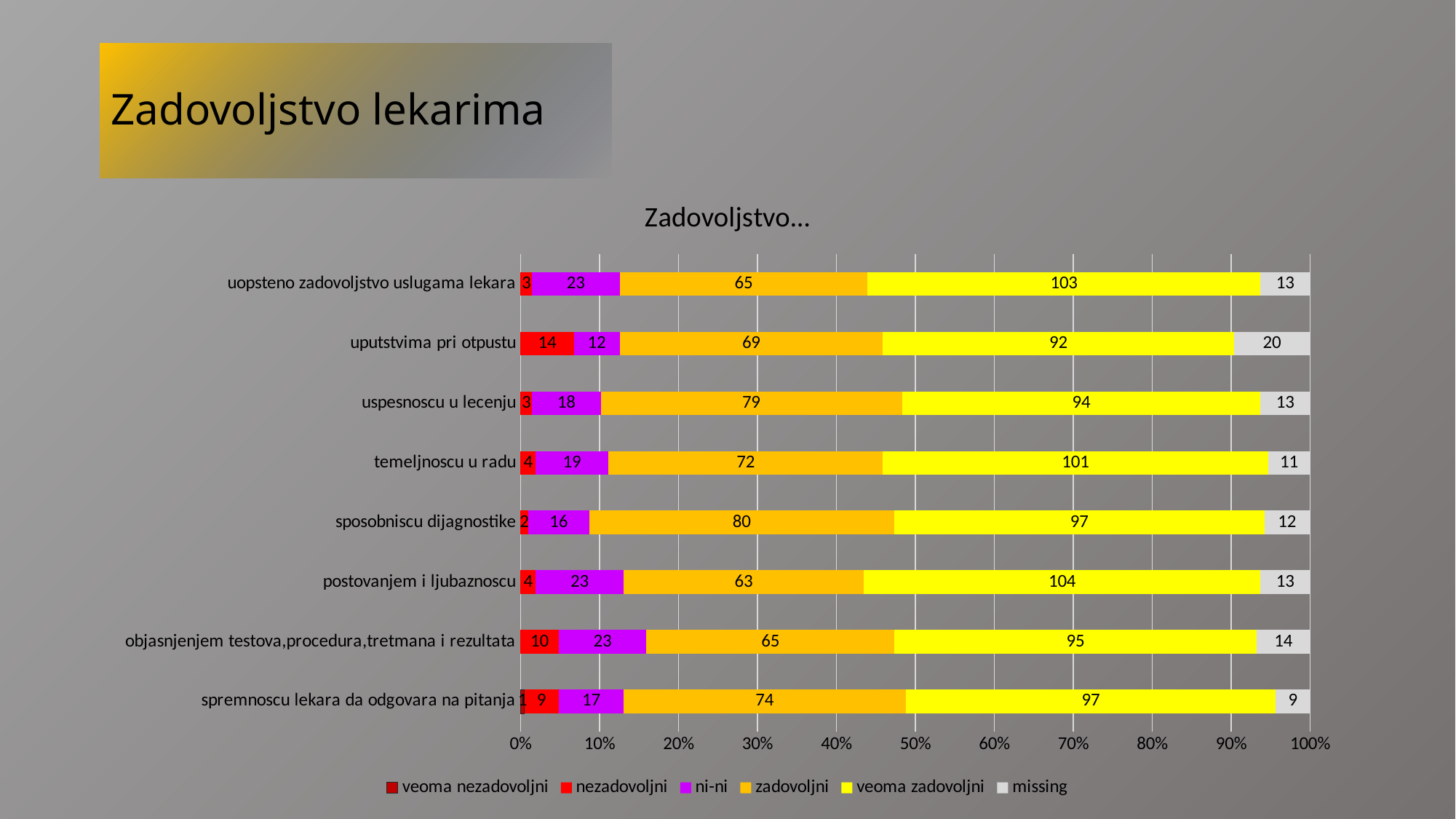
Which category has the lowest 'veoma zadovoljni' value? uputstvima pri otpustu What is the difference between the 'zadovoljni' values for 'uspesnoscu u lecenju' and 'uopsteno zadovoljstvo uslugama lekara'? 14 What is the value of the 'veoma zadovoljni' series for 'uopsteno zadovoljstvo uslugama lekara'? 103 What kind of chart is shown on the slide? Stacked bar chart How many series does the legend list? 6 What is the 'zadovoljni' value for 'sposobniscu dijagnostike'? 80 Which category has the highest 'veoma zadovoljni' value? postovanjem i ljubaznoscu Which has the larger 'ni-ni' value: 'uputstvima pri otpustu' or 'uspesnoscu u lecenju'? uspesnoscu u lecenju How many categories are shown on the chart? 8 What is the 'missing' value for 'uputstvima pri otpustu'? 20 What is the 'nezadovoljni' value for 'objasnjenjem testova,procedura,tretmana i rezultata'? 10 Which category has the highest 'nezadovoljni' value? uputstvima pri otpustu